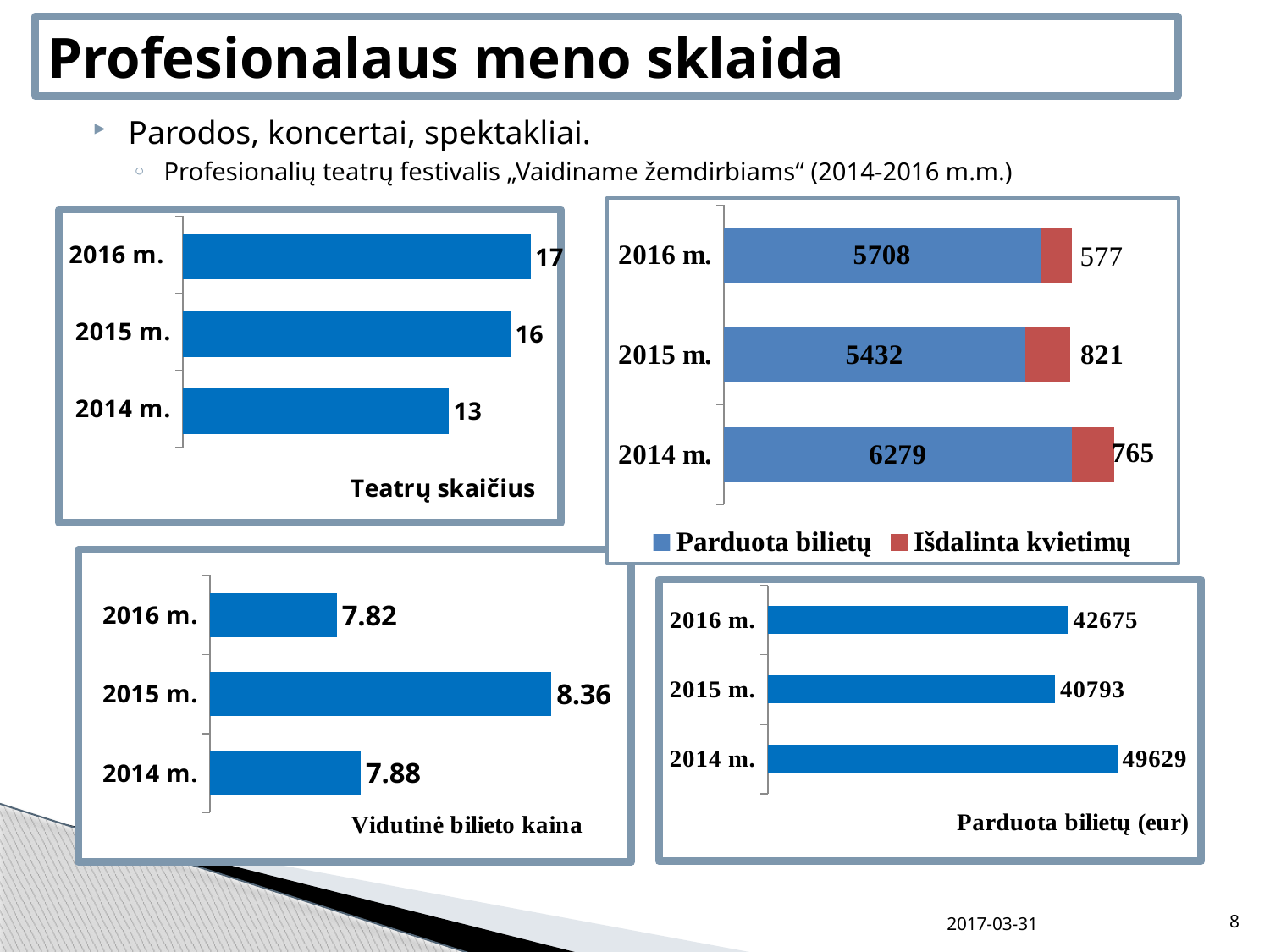
In the 'Teatrų skaičius' chart, what is the value for 2016 m.? 17 What kind of chart is the 'Parduota bilietų (eur)' chart? Bar chart In the top-right stacked bar chart, what is the total of the 2014 m. bar? 7044 In the 'Teatrų skaičius' chart, what is the difference between the values for 2016 m. and 2014 m.? 4 In the 'Vidutinė bilieto kaina' chart, what is the value for 2015 m.? 8.36 In the 'Parduota bilietų (eur)' chart, what is the value for 2014 m.? 49629 How many series does the legend of the top-right stacked bar chart list? 2 In the 'Parduota bilietų (eur)' chart, which is larger, the value for 2016 m. or 2015 m.? 2016 m. In the top-right stacked bar chart, what is the 'Išdalinta kvietimų' value for 2016 m.? 577 In the top-right stacked bar chart, what is the 'Parduota bilietų' value for 2015 m.? 5432 In the 'Teatrų skaičius' chart, which year has the lowest value? 2014 m. In the 'Vidutinė bilieto kaina' chart, which year has the highest value? 2015 m.